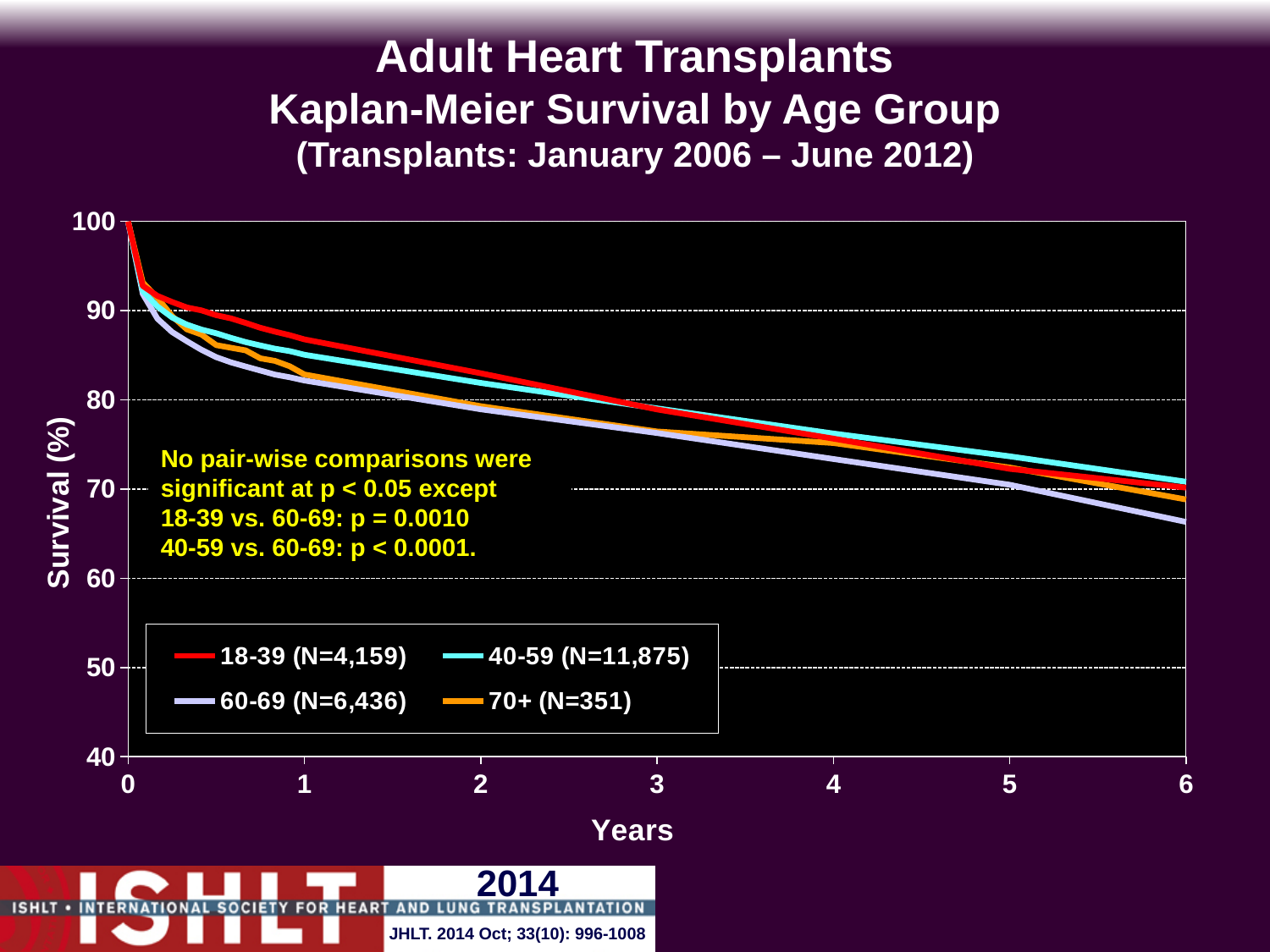
Do the survival curves rise or fall as years since transplant increase? fall What is the N for the 18-39 age group shown in the legend? N=4,159 Is the survival for the 60-69 group at 6 years greater or less than 70? less How many age groups (series) does the legend list? 4 What is the N for the 60-69 age group shown in the legend? N=6,436 At 6 years, which group has higher survival: 40-59 or 60-69? 40-59 What kind of chart is shown on the slide? line chart Which age group has the lowest survival at 6 years? 60-69 What is the N for the 70+ age group shown in the legend? N=351 What is the N for the 40-59 age group shown in the legend? N=11,875 Is the survival for the 18-39 group at 1 year greater or less than 80? greater What is the label of the x axis? Years